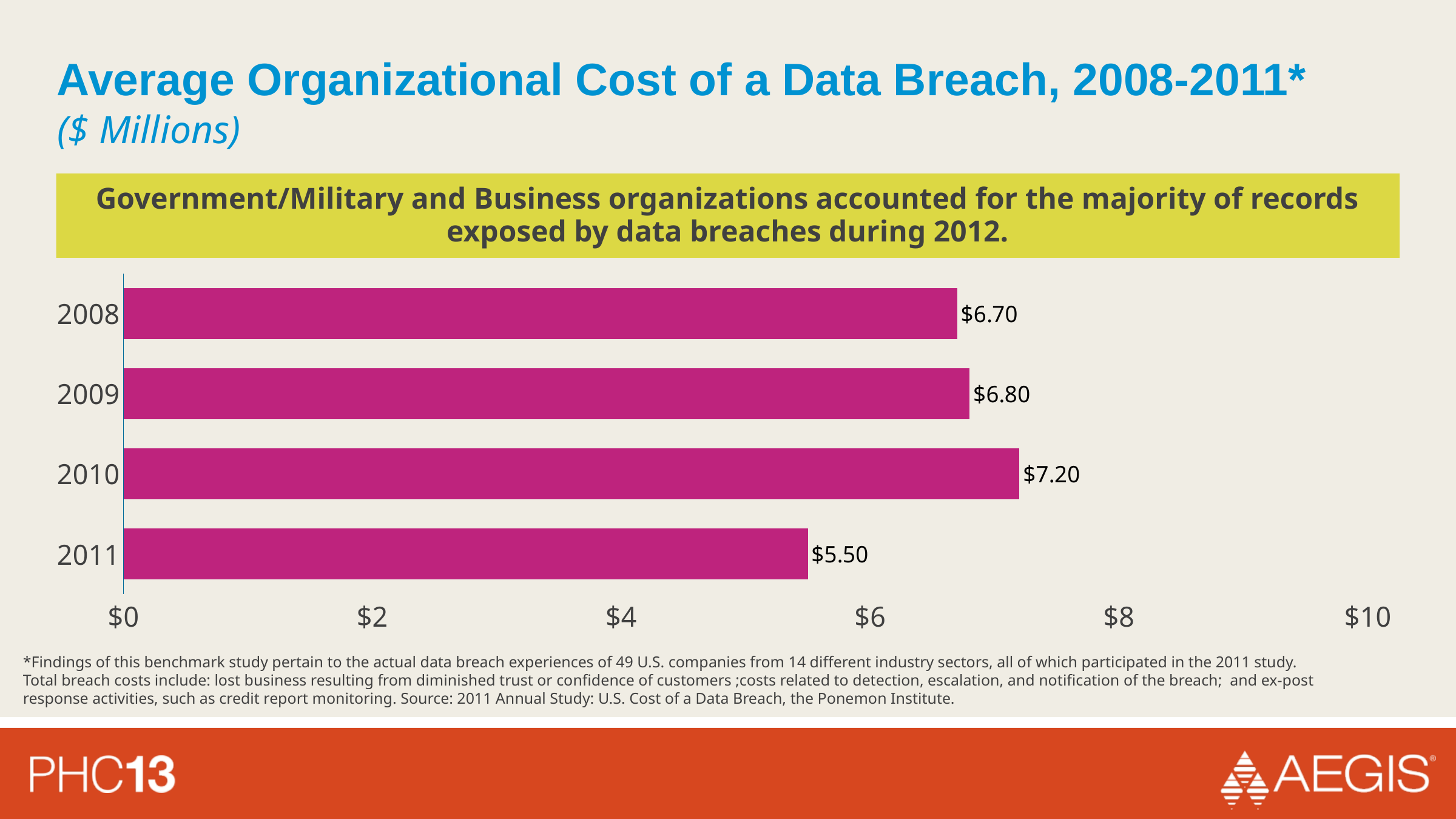
Which year had the lowest average organizational cost of a data breach? 2011 What is the unit given in the chart's subtitle? $ Millions Is the value for 2011 greater or less than $6? less What kind of chart is shown on the slide? Bar chart Which year had the highest average organizational cost of a data breach? 2010 How many years are shown in the chart? 4 Which year had a higher average cost, 2009 or 2011? 2009 What is the difference between the average cost in 2010 and the average cost in 2011? $1.70 What was the average organizational cost of a data breach in 2010? $7.20 What is the difference between the average cost in 2009 and the average cost in 2008? $0.10 What was the average organizational cost of a data breach in 2011? $5.50 What was the average organizational cost of a data breach in 2008? $6.70